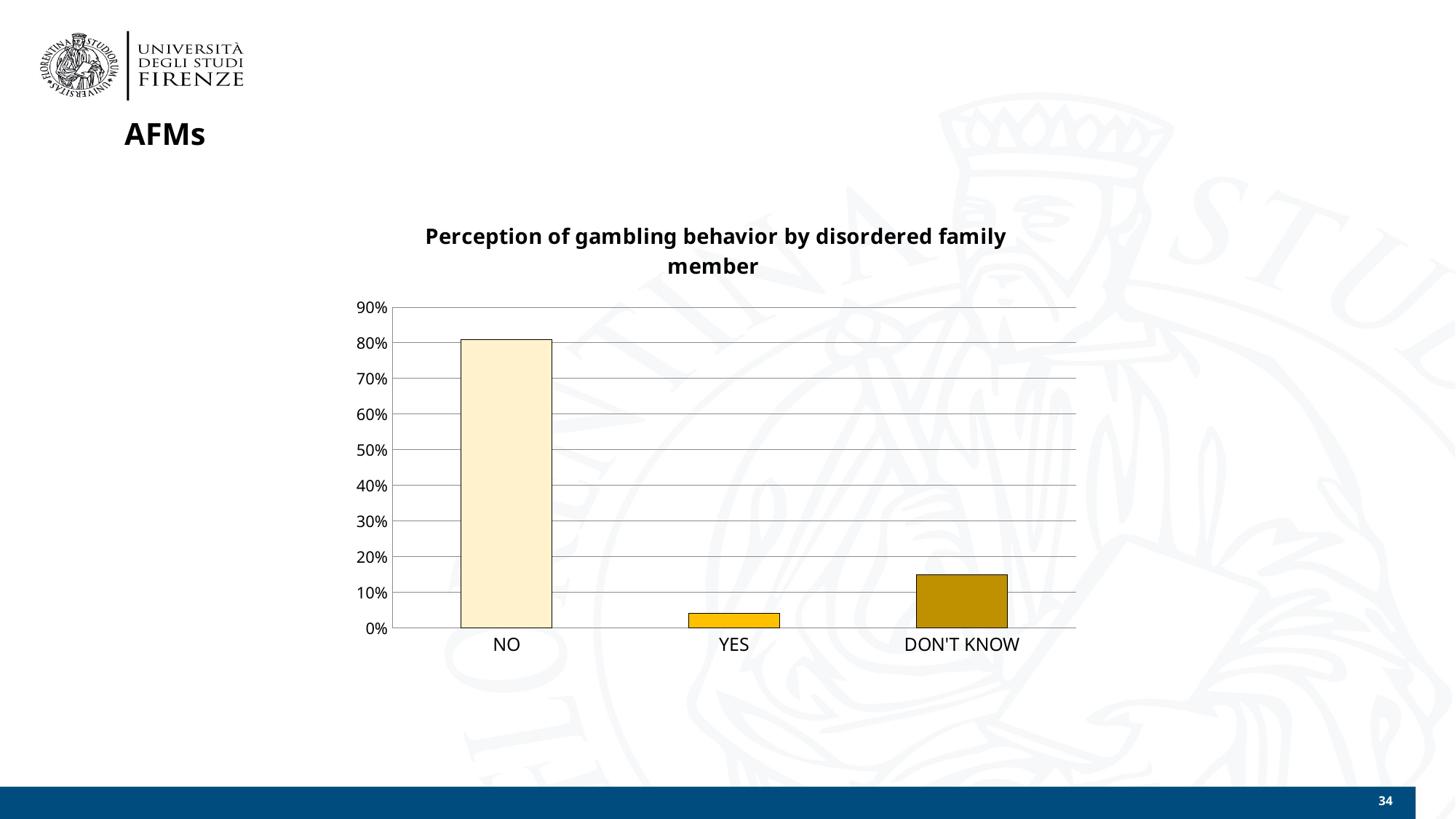
Is the value for DON'T KNOW greater or less than 10%? greater What type of chart is shown on the slide? bar chart Is the value for YES greater or less than 10%? less Is the value for DON'T KNOW greater or less than 20%? less Which is larger, the value for YES or the value for DON'T KNOW? DON'T KNOW What is the maximum value shown on the y axis of the chart? 90% Which is larger, the value for NO or the value for DON'T KNOW? NO Which category has the lowest value? YES What is the title of the chart? Perception of gambling behavior by disordered family member Which category has the highest value? NO How many categories are shown on the x axis of the chart? 3